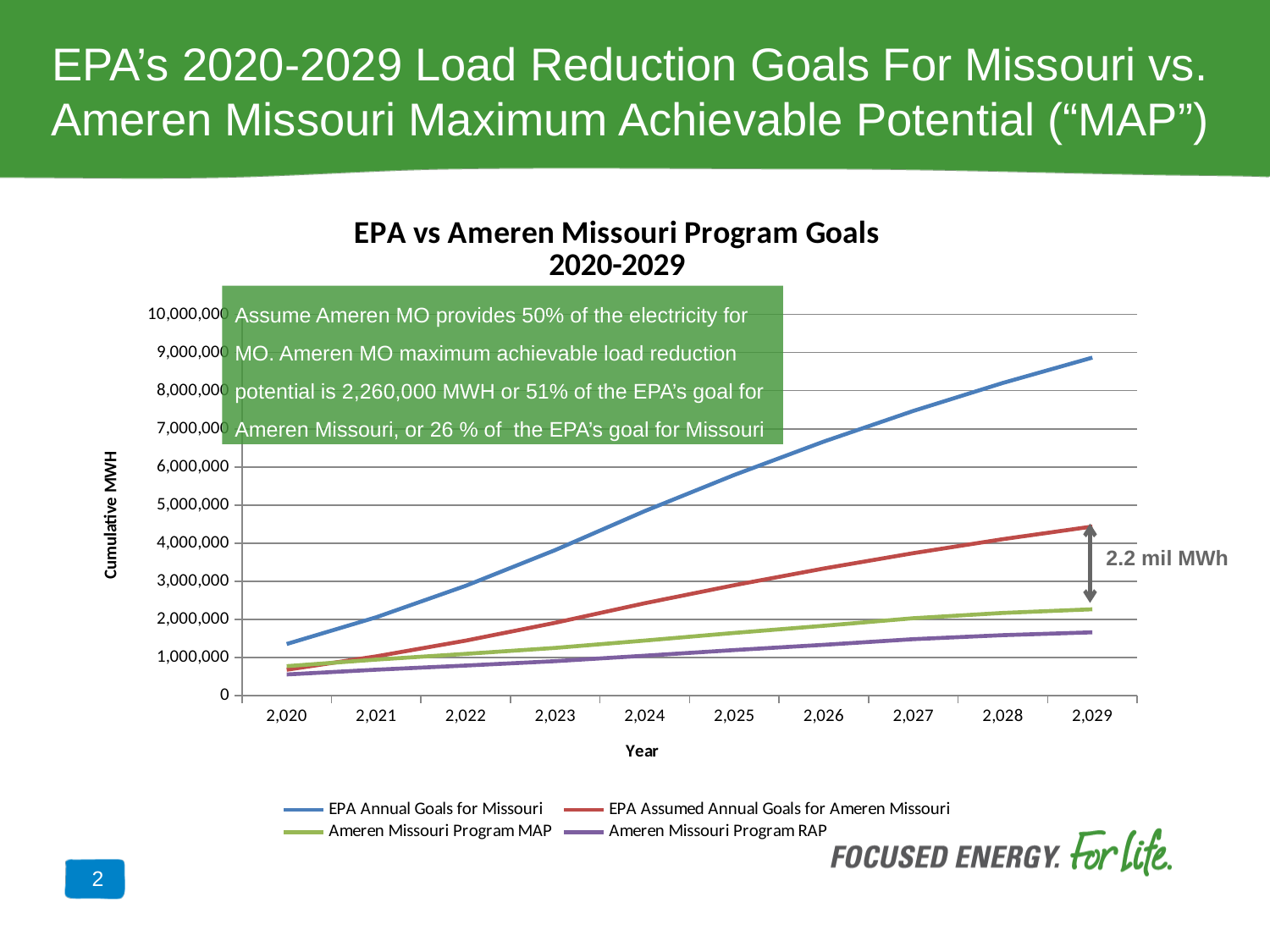
Do the values for EPA Annual Goals for Missouri rise or fall from 2020 to 2029? rise Which series has the lowest value in 2029? Ameren Missouri Program RAP Which is larger in 2025: EPA Annual Goals for Missouri or Ameren Missouri Program MAP? EPA Annual Goals for Missouri Is the value for EPA Annual Goals for Missouri in 2020 greater or less than 1,000,000? greater Is the value for Ameren Missouri Program RAP in 2029 greater or less than 2,000,000? less What is the label on the y axis of the chart? Cumulative MWH Is the value for EPA Annual Goals for Missouri in 2029 greater or less than 8,000,000? greater What kind of chart is shown on the slide? line chart Which series has the highest value in 2029? EPA Annual Goals for Missouri How many series does the legend list? 4 How many years are plotted along the x axis? 10